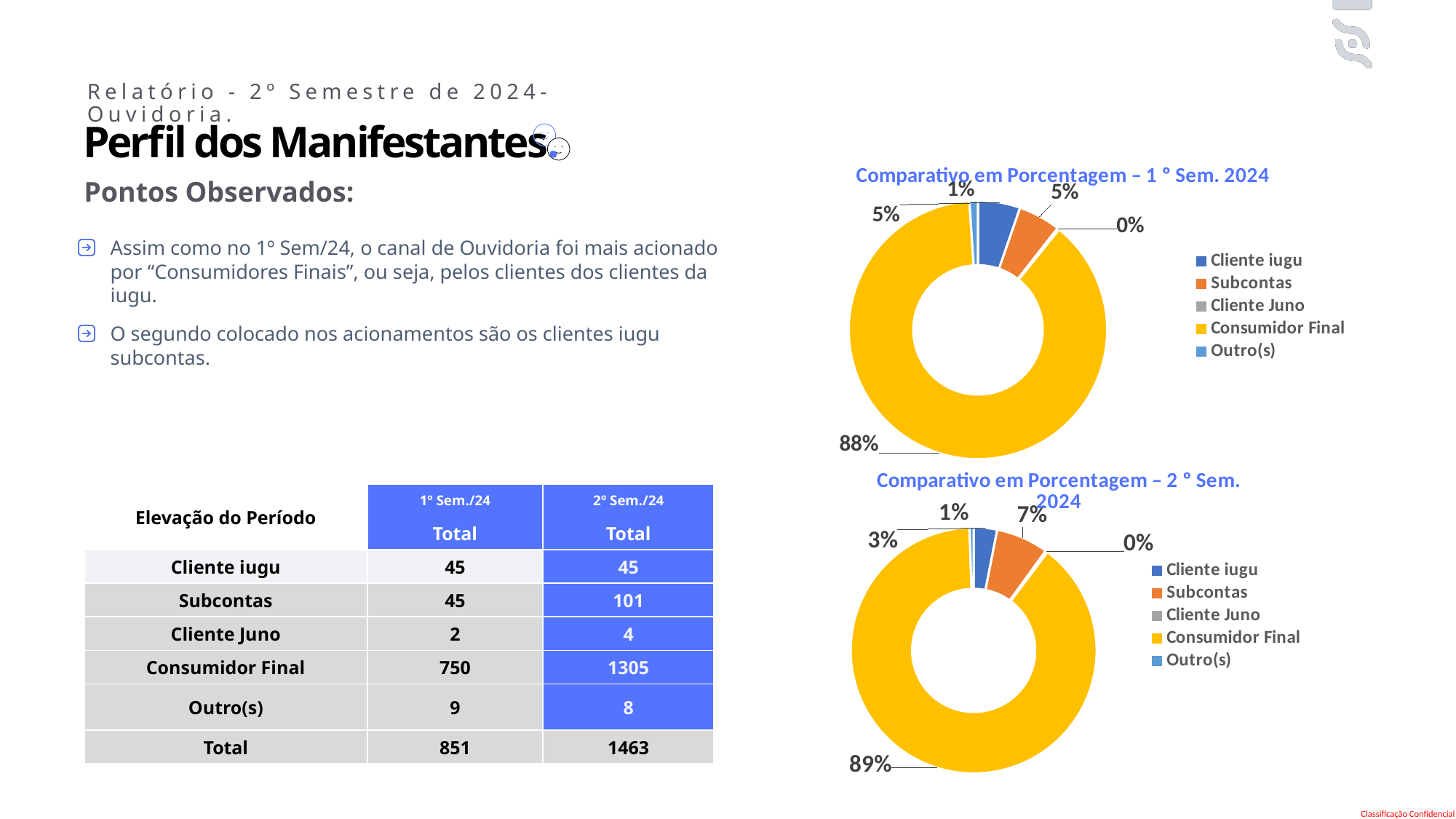
In the chart titled "Comparativo em Porcentagem – 2 ° Sem. 2024", what percentage is shown for Consumidor Final? 89% In the chart titled "Comparativo em Porcentagem – 2 ° Sem. 2024", which is larger, the share for Subcontas or the share for Cliente iugu? Subcontas In the chart titled "Comparativo em Porcentagem – 2 ° Sem. 2024", which category has the smallest share? Cliente Juno In the chart titled "Comparativo em Porcentagem – 1 ° Sem. 2024", what percentage is shown for Cliente Juno? 0% In the chart titled "Comparativo em Porcentagem – 1 ° Sem. 2024", what percentage is shown for Consumidor Final? 88% In the chart titled "Comparativo em Porcentagem – 1 ° Sem. 2024", which colour represents Consumidor Final? Yellow In the chart titled "Comparativo em Porcentagem – 2 ° Sem. 2024", what percentage is shown for Cliente iugu? 3% In the chart titled "Comparativo em Porcentagem – 2 ° Sem. 2024", what is the difference in percentage points between Consumidor Final and Subcontas? 82 percentage points In the chart titled "Comparativo em Porcentagem – 2 ° Sem. 2024", what percentage is shown for Subcontas? 7% How many categories does the legend of the chart titled "Comparativo em Porcentagem – 1 ° Sem. 2024" list? 5 In the chart titled "Comparativo em Porcentagem – 1 ° Sem. 2024", which category has the largest share? Consumidor Final What kind of chart is the chart titled "Comparativo em Porcentagem – 2 ° Sem. 2024"? Doughnut (pie) chart